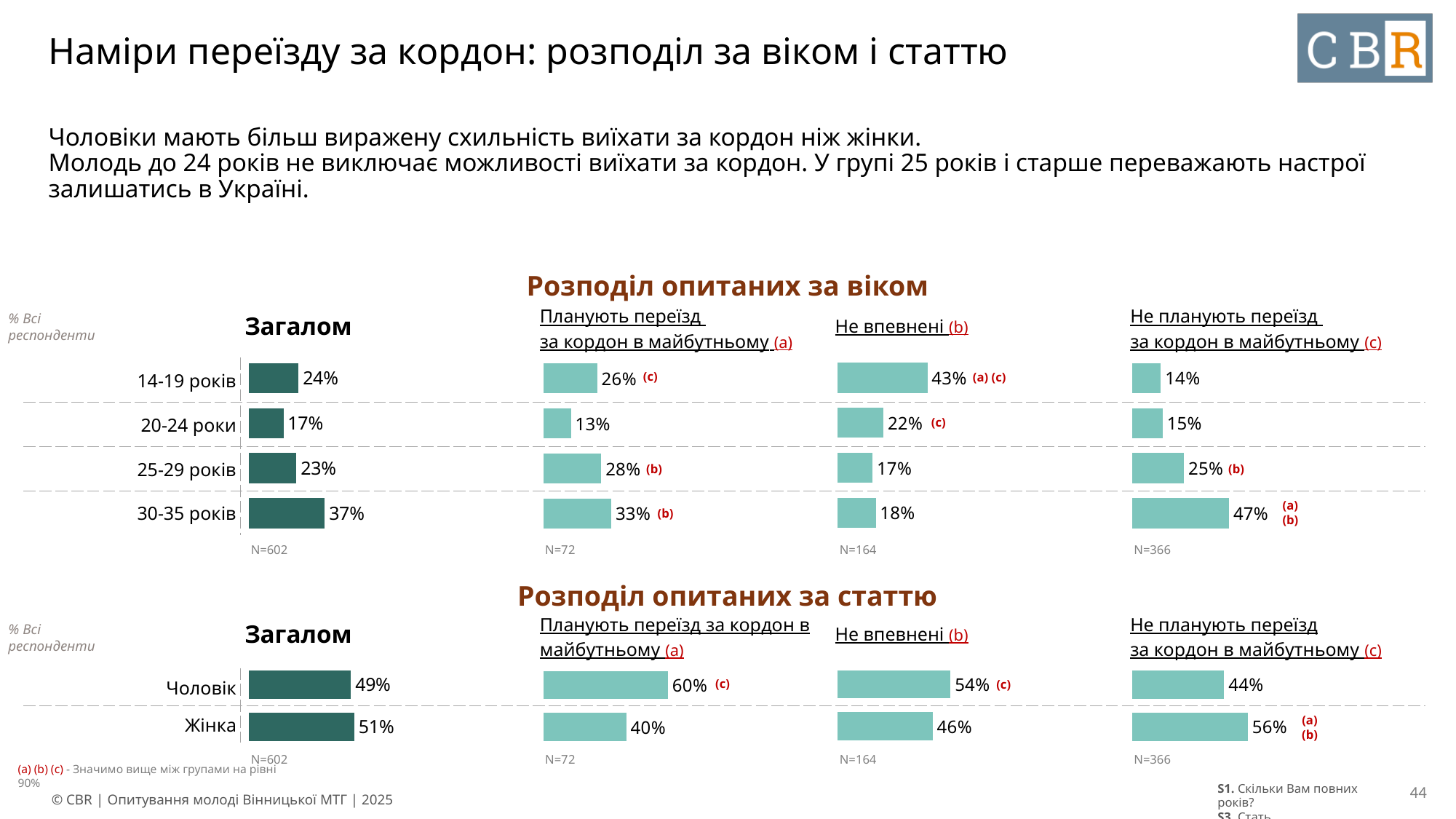
In the 'Розподіл опитаних за віком' chart, which age group has the highest value in the 'Не планують переїзд за кордон в майбутньому' column? 30-35 років In the 'Розподіл опитаних за статтю' chart, what is the difference between the 'Планують переїзд за кордон в майбутньому' values for Чоловік and Жінка? 20 percentage points In the 'Розподіл опитаних за статтю' chart, which is larger in the 'Не впевнені' column: Чоловік or Жінка? Чоловік In the 'Розподіл опитаних за статтю' chart, what is the value for Жінка in the 'Не планують переїзд за кордон в майбутньому' column? 56% In the 'Розподіл опитаних за статтю' chart, what is the value for Чоловік in the 'Планують переїзд за кордон в майбутньому' column? 60% In the 'Розподіл опитаних за віком' chart, what is the value for 14-19 років in the 'Не впевнені' column? 43% What is the N (sample size) shown under the 'Не впевнені' column? N=164 In the 'Розподіл опитаних за віком' chart, how many age groups are shown? 4 What type of chart is used on this slide? Bar chart In the 'Розподіл опитаних за віком' chart, what is the difference between the 'Не впевнені' values for 14-19 років and 20-24 роки? 21 percentage points In the 'Розподіл опитаних за віком' chart, which age group has the lowest value in the 'Планують переїзд за кордон в майбутньому' column? 20-24 роки In the 'Розподіл опитаних за віком' chart, what is the value for 30-35 років in the 'Загалом' column? 37%